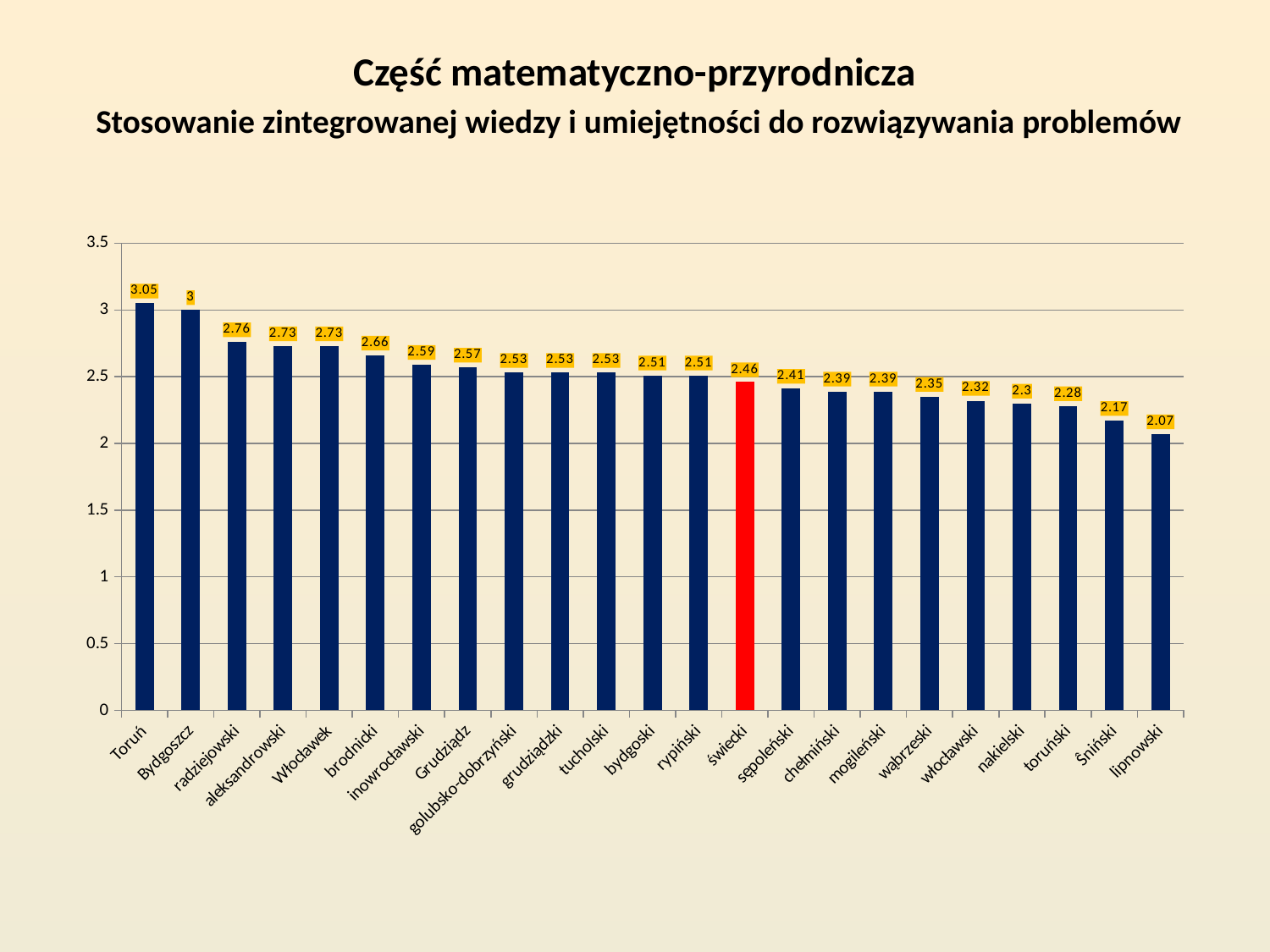
Which category has the lowest value? lipnowski What is the value for świecki? 2.46 What is the value for brodnicki? 2.66 Which bar is coloured red instead of dark blue? świecki What is the value for Toruń? 3.05 What is the value for lipnowski? 2.07 Which has a larger value, Bydgoszcz or radziejowski? Bydgoszcz Is the value for nakielski greater or less than 2.5? less Which category has the highest value? Toruń What kind of chart is shown on the slide? bar chart What is the difference between the values for Toruń and lipnowski? 0.98 How many categories are shown on the x axis? 23